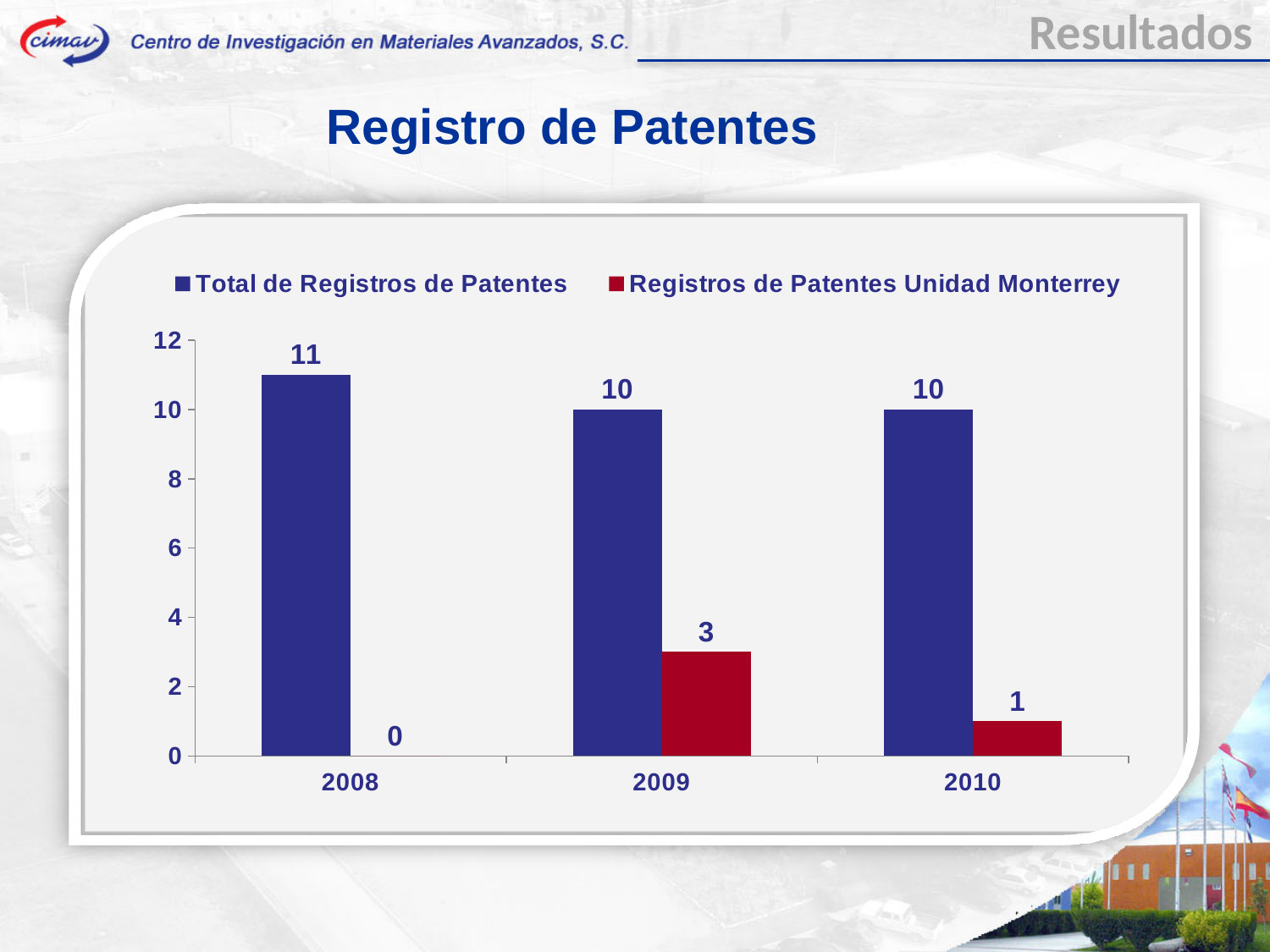
What is the value of Registros de Patentes Unidad Monterrey for 2009? 3 What is the difference between Total de Registros de Patentes and Registros de Patentes Unidad Monterrey in 2009? 7 Which is larger: Registros de Patentes Unidad Monterrey in 2009 or in 2010? 2009 What is the value of Total de Registros de Patentes for 2008? 11 What is the title of the chart? Registro de Patentes Which year has the highest value for Total de Registros de Patentes? 2008 What is the value of Registros de Patentes Unidad Monterrey for 2010? 1 What is the value of Registros de Patentes Unidad Monterrey for 2008? 0 How many series does the legend list? 2 What kind of chart is shown on the slide? Bar chart Which year has the highest value for Registros de Patentes Unidad Monterrey? 2009 How many years are shown on the x axis? 3